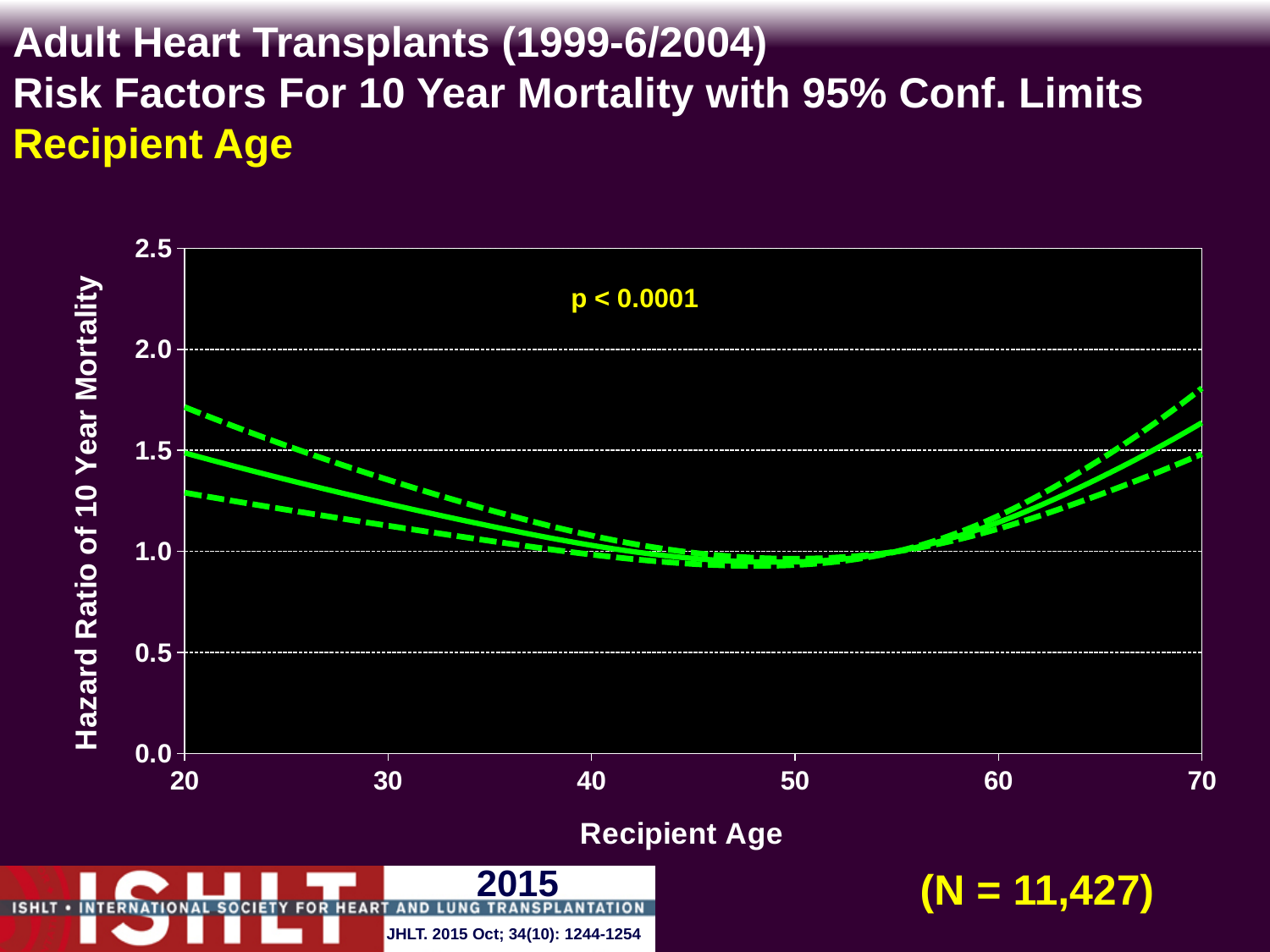
Is the hazard ratio (solid line) at recipient age 70 greater or less than 1.5? greater What sample size (N) is shown on the slide? N = 11,427 Is the hazard ratio (solid line) at recipient age 20 greater or less than 2.0? less Is the upper confidence limit (upper dashed line) at recipient age 70 greater or less than 1.5? greater What kind of chart is shown on the slide? line chart Does the hazard ratio rise or fall as recipient age increases from 55 to 70? rise What p-value is printed on the chart? p < 0.0001 Which has the higher hazard ratio on the solid line: recipient age 20 or recipient age 50? recipient age 20 How many lines are plotted on the chart? 3 Does the hazard ratio rise or fall as recipient age increases from 20 to 45? fall